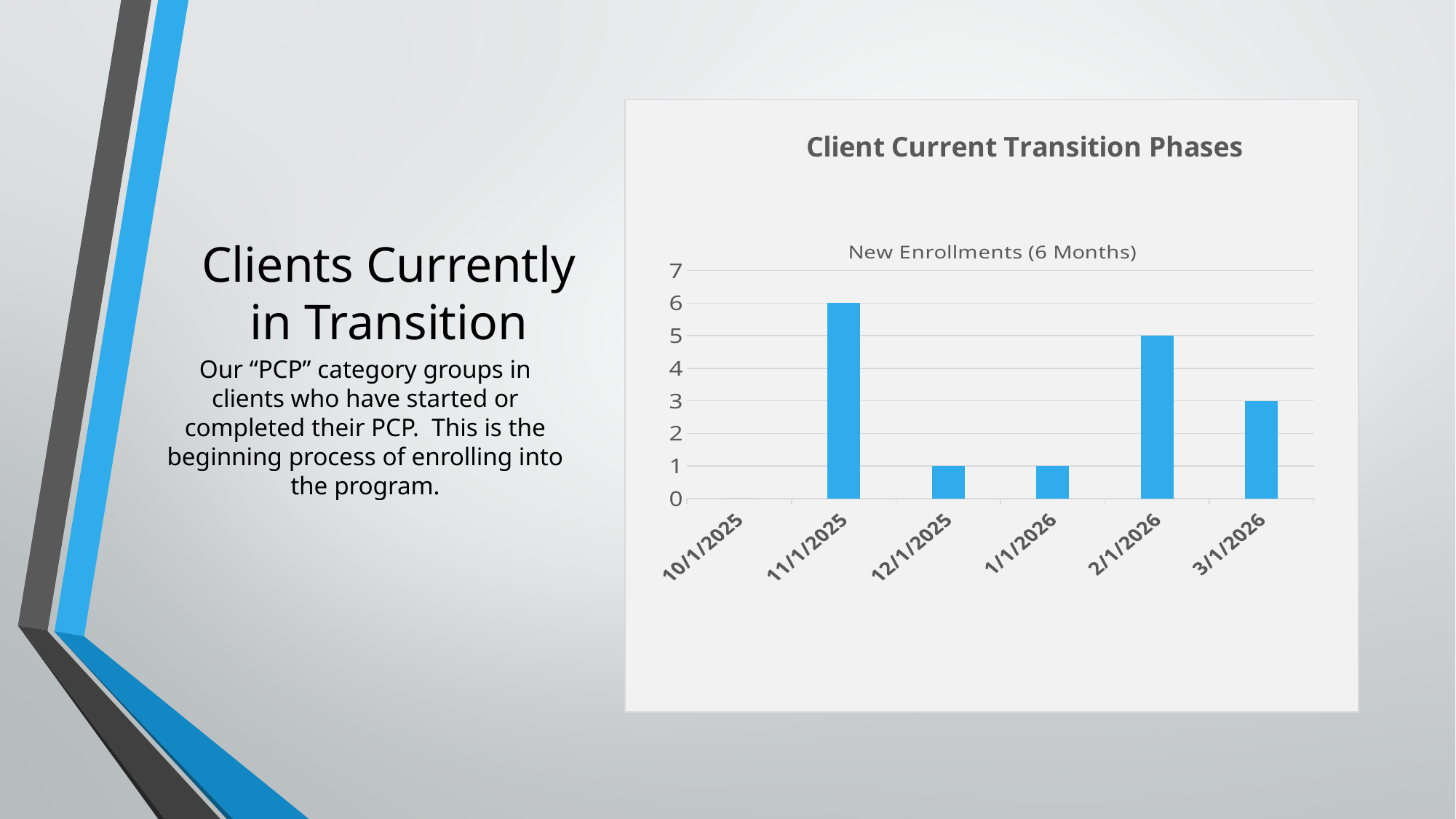
What is the name of the series plotted in the chart? New Enrollments (6 Months) What is the title of the chart? Client Current Transition Phases How many dates are shown on the x axis? 6 What is the value for 3/1/2026? 3 What is the value for 12/1/2025? 1 Which date has the lowest value? 10/1/2025 What type of chart is shown on the slide? bar chart What is the value for 2/1/2026? 5 What is the difference between the values for 11/1/2025 and 2/1/2026? 1 What is the value for 11/1/2025? 6 Which is larger, the value for 2/1/2026 or the value for 3/1/2026? 2/1/2026 Which date has the highest value? 11/1/2025